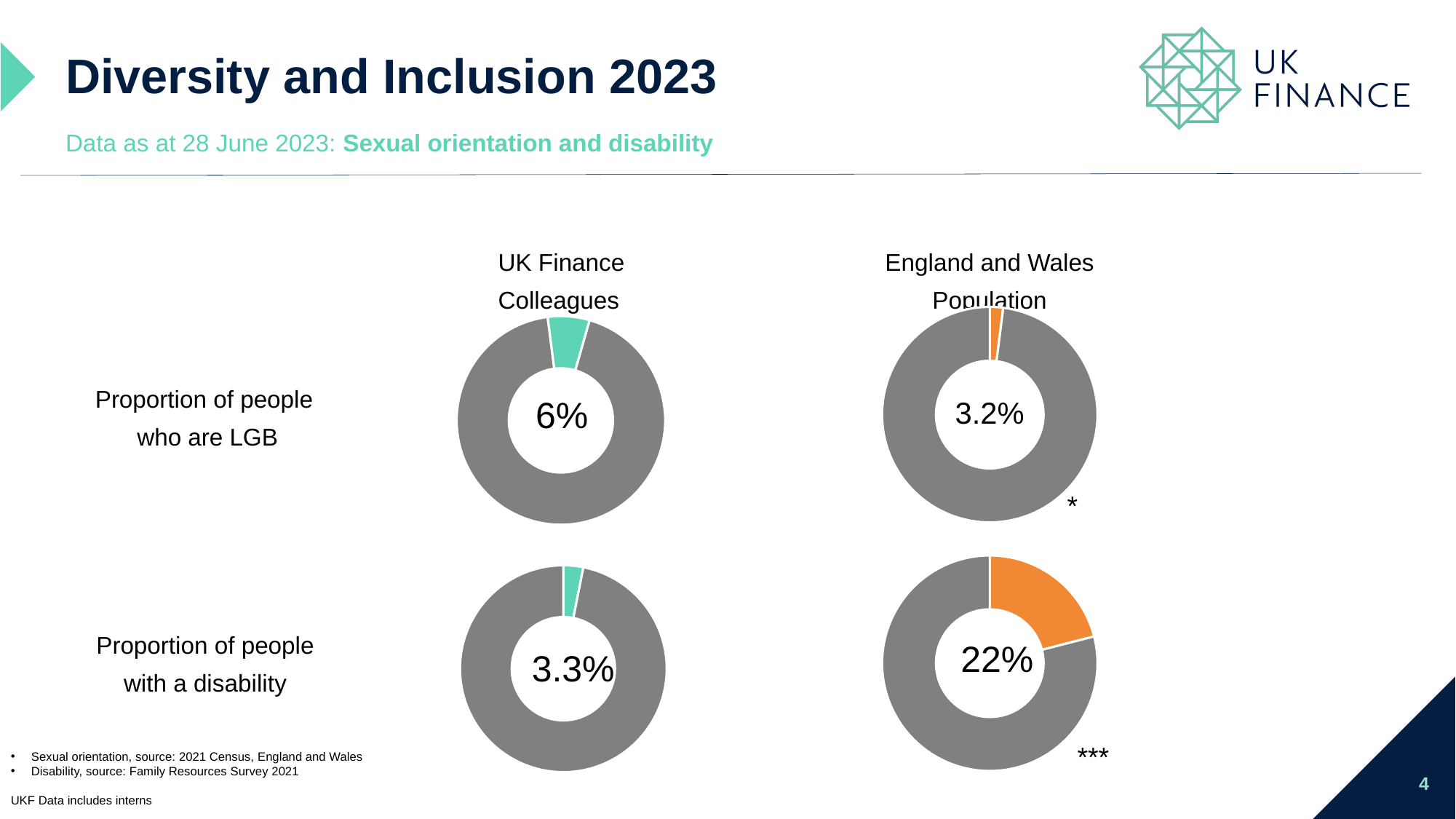
In the top-right donut chart, what proportion of the England and Wales population is LGB? 3.2% By how many percentage points does the UK Finance LGB proportion (top-left chart) exceed the England and Wales LGB proportion (top-right chart)? 2.8 percentage points Across all four donut charts on the slide, which one shows the lowest proportion? England and Wales Population, proportion of people who are LGB (3.2%) By how many percentage points does the England and Wales disability proportion (bottom-right chart) exceed the UK Finance disability proportion (bottom-left chart)? 18.7 percentage points Comparing the two disability donut charts, which is higher: the UK Finance colleagues proportion or the England and Wales population proportion? England and Wales Population How many donut charts are shown on the slide? 4 Across all four donut charts on the slide, which one shows the highest proportion? England and Wales Population, proportion of people with a disability (22%) In the bottom-left donut chart, what proportion of UK Finance colleagues have a disability? 3.3% In the bottom-right donut chart, what proportion of the England and Wales population has a disability? 22% What colour is used for the highlighted slice in the England and Wales Population donut charts? Orange Comparing the two LGB donut charts, which is higher: the UK Finance colleagues proportion or the England and Wales population proportion? UK Finance Colleagues In the top-left donut chart, what proportion of UK Finance colleagues are LGB? 6%